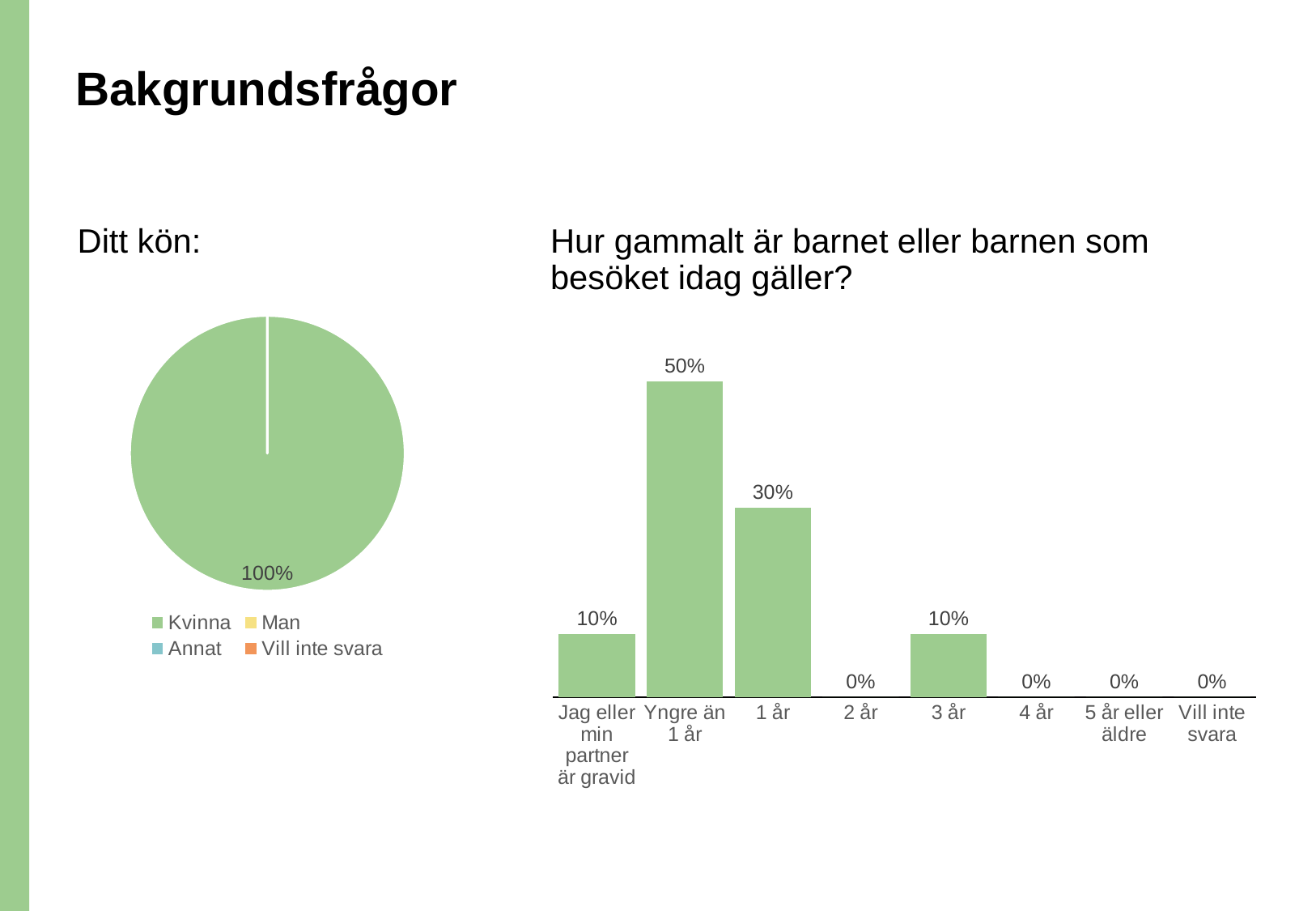
In the 'Hur gammalt är barnet eller barnen som besöket idag gäller?' chart, which is larger: '1 år' or '3 år'? 1 år In the 'Hur gammalt är barnet eller barnen som besöket idag gäller?' chart, what is the difference between 'Yngre än 1 år' and '1 år'? 20% In the 'Hur gammalt är barnet eller barnen som besöket idag gäller?' chart, what is the value for '4 år'? 0% In the 'Ditt kön:' chart, what share does Kvinna have? 100% In the 'Hur gammalt är barnet eller barnen som besöket idag gäller?' chart, what is the value for 'Yngre än 1 år'? 50% In the 'Ditt kön:' chart, what kind of chart is shown? pie chart In the 'Hur gammalt är barnet eller barnen som besöket idag gäller?' chart, what is the value for '1 år'? 30% In the 'Hur gammalt är barnet eller barnen som besöket idag gäller?' chart, how many categories are shown on the x axis? 8 In the 'Ditt kön:' chart, how many entries does the legend list? 4 In the 'Hur gammalt är barnet eller barnen som besöket idag gäller?' chart, what kind of chart is shown? bar chart In the 'Hur gammalt är barnet eller barnen som besöket idag gäller?' chart, which category has the highest value? Yngre än 1 år In the 'Hur gammalt är barnet eller barnen som besöket idag gäller?' chart, what is the value for '3 år'? 10%